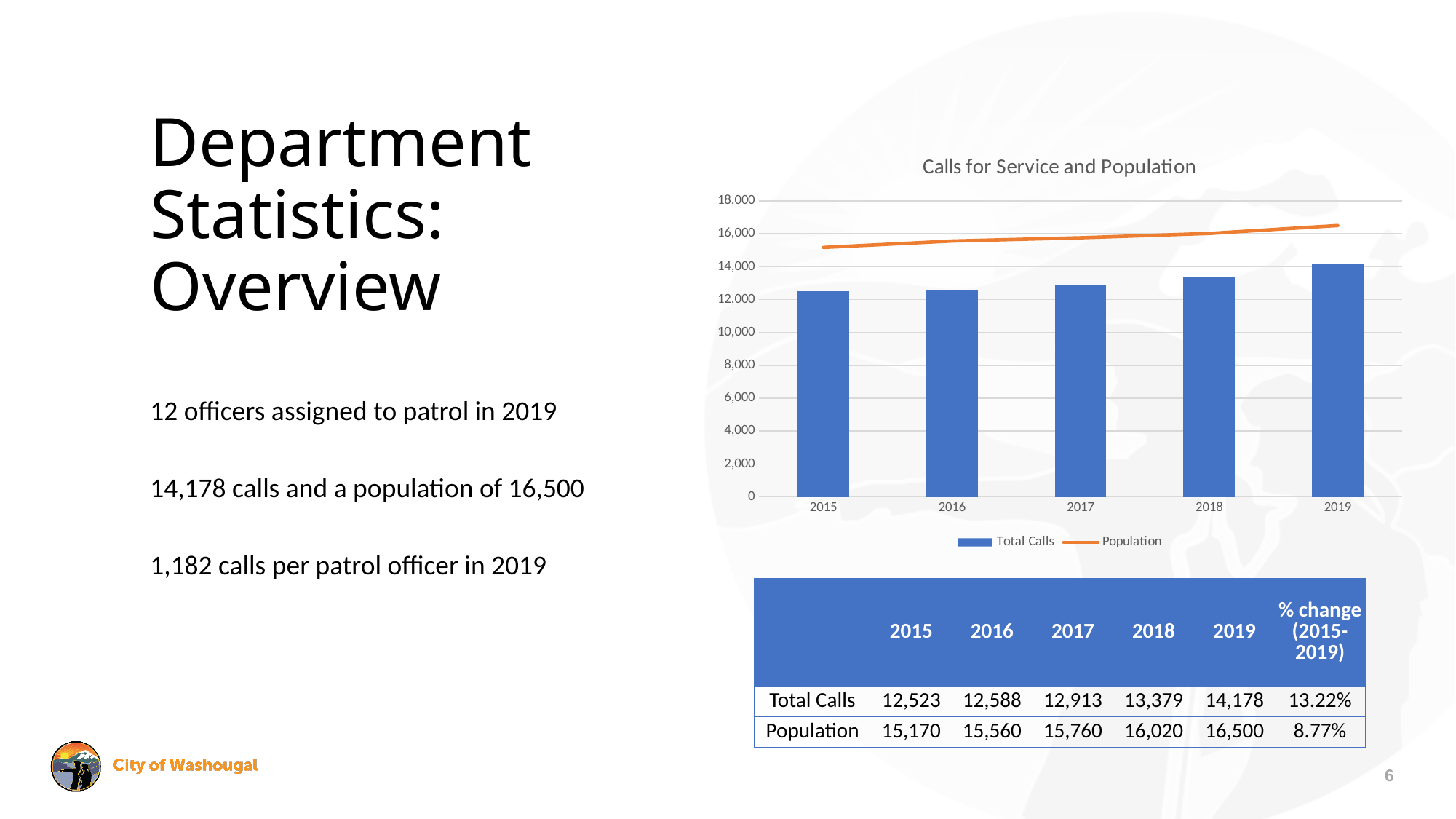
What kind of chart is used to show Total Calls? Bar chart Is the Total Calls value for 2018 greater or less than 14,000? less What is the difference in Total Calls between 2019 and 2015? 1,655 Which is larger in 2017, Total Calls or Population? Population Which year has the highest Total Calls? 2019 What is the title of the chart? Calls for Service and Population What is the Population value for 2015? 15,170 How many years are shown on the x axis of the chart? 5 Do Total Calls rise or fall from 2015 to 2019? Rise Which year has the lowest Total Calls? 2015 How many series does the chart legend list? 2 What is the value of Total Calls for 2019? 14,178